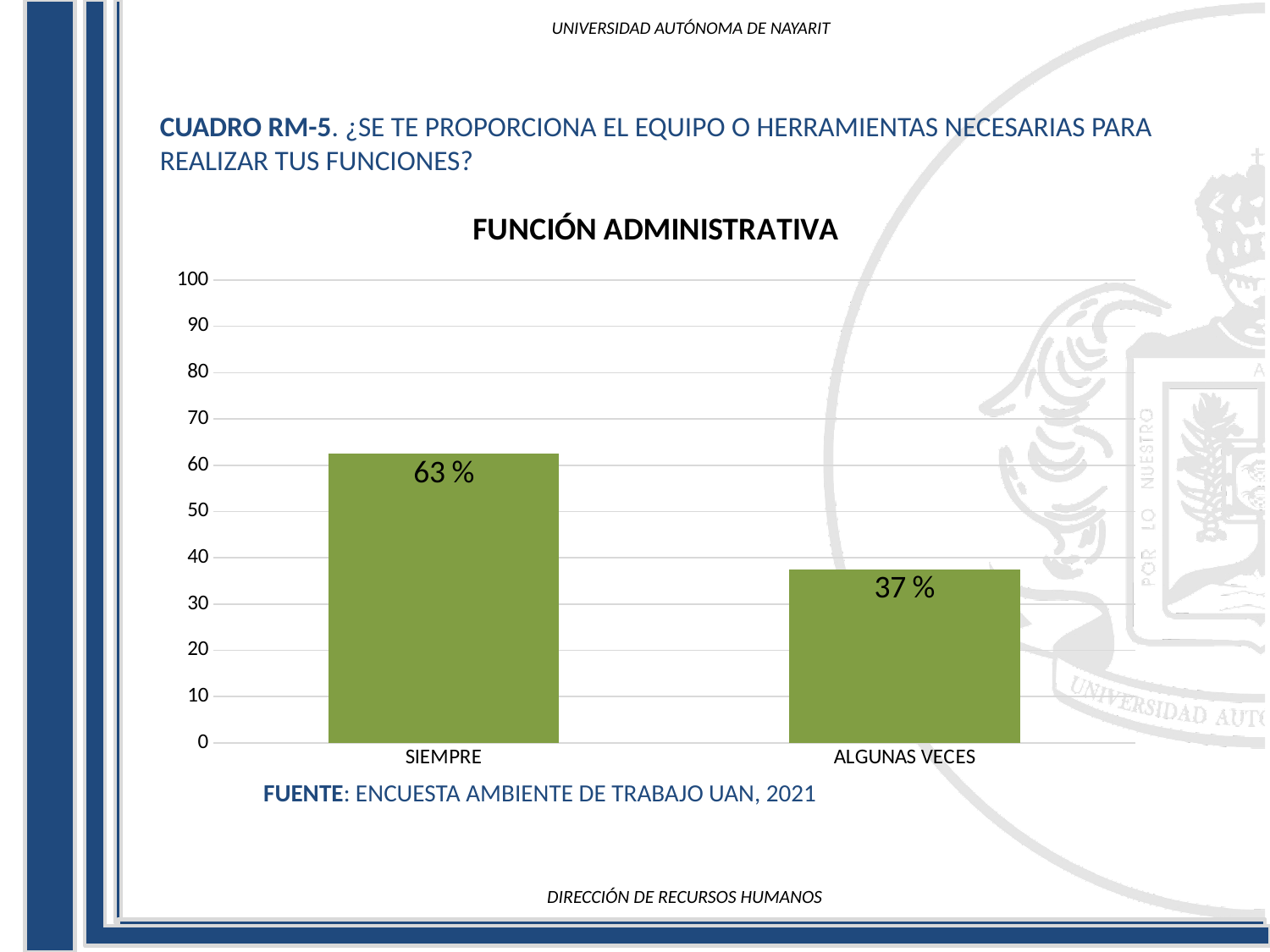
What kind of chart is shown on the slide? bar chart What is the title of the chart? FUNCIÓN ADMINISTRATIVA Is the value for SIEMPRE greater or less than 60? greater What is the value for ALGUNAS VECES? 37 % What is the difference between the values for SIEMPRE and ALGUNAS VECES? 26 % Is the value for ALGUNAS VECES greater or less than 40? less What is the value for SIEMPRE? 63 % Which is larger, the value for SIEMPRE or the value for ALGUNAS VECES? SIEMPRE Which category has the highest value? SIEMPRE What is the maximum value shown on the y axis? 100 How many categories are shown on the x axis? 2 Which category has the lowest value? ALGUNAS VECES